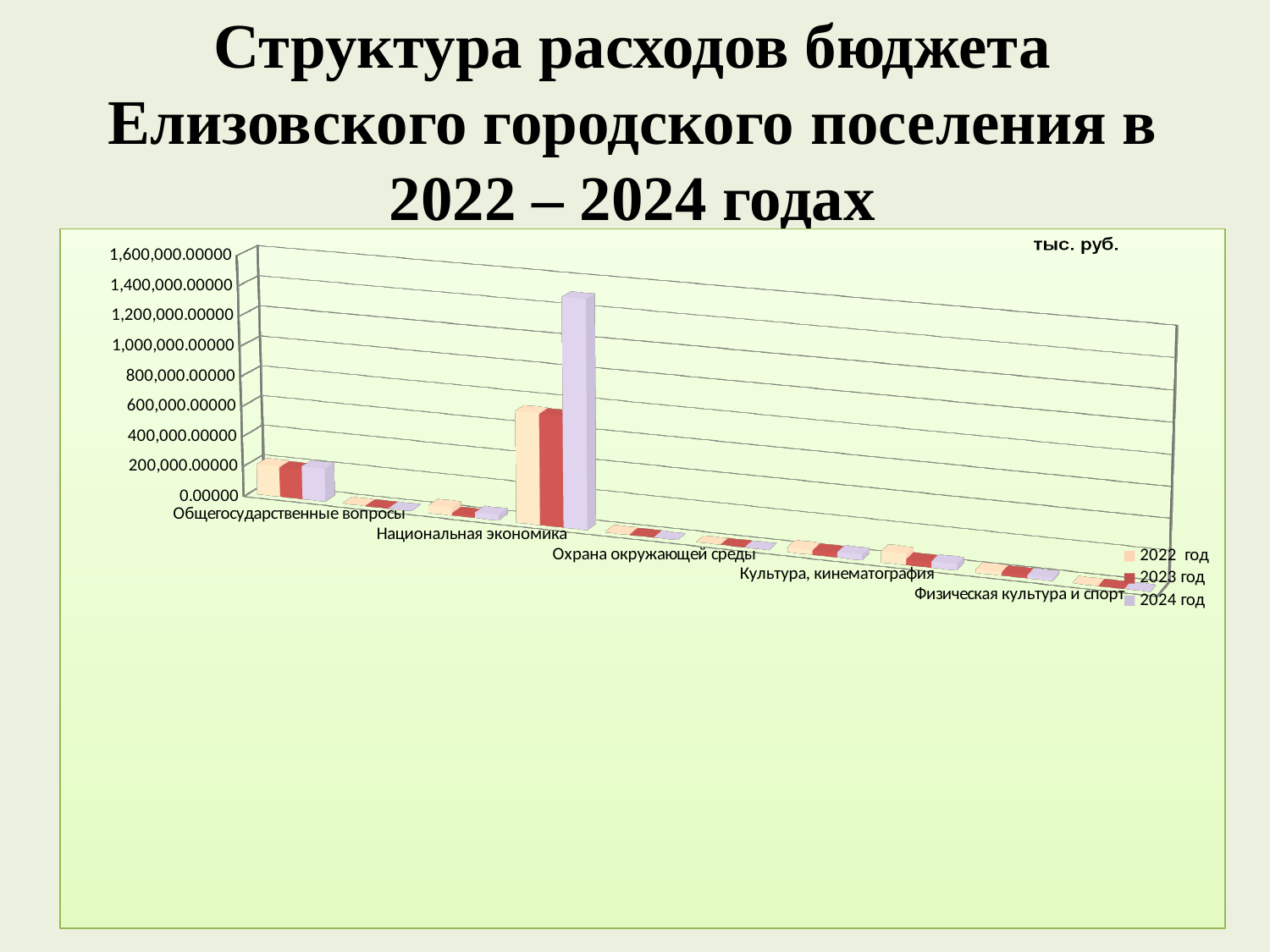
Is the 2022 год value for Охрана окружающей среды greater or less than 200,000.00000? less Which is larger: the 2022 год value for Общегосударственные вопросы or the 2022 год value for Охрана окружающей среды? Общегосударственные вопросы Which is larger: the 2024 год value for Физическая культура и спорт or the 2024 год value for Общегосударственные вопросы? Общегосударственные вопросы Is the tallest bar on the chart greater or less than 800,000.00000? greater What are the three series named in the chart legend? 2022 год, 2023 год, 2024 год What unit is indicated in the top-right corner of the chart? тыс. руб. What kind of chart is shown on the slide? Bar chart What is the highest value shown on the vertical axis of the chart? 1,600,000.00000 Is the 2022 год value for Общегосударственные вопросы greater or less than 400,000.00000? less How many series does the chart legend list? 3 Which series (year) has the single tallest bar on the chart? 2024 год